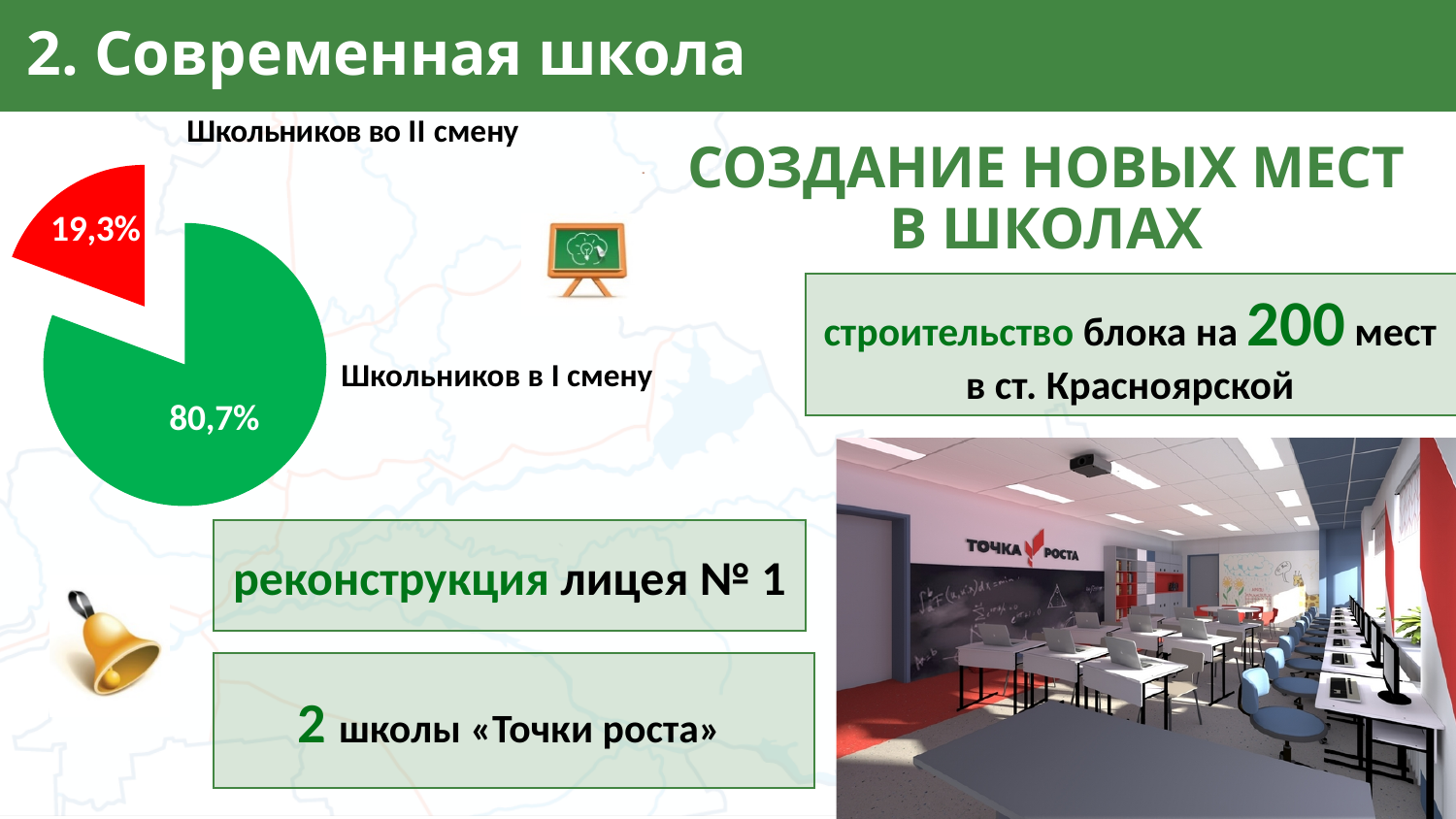
Is the share for "Школьников во II смену" in the pie chart greater or less than 50%? less What kind of chart is shown on the left of the slide? pie chart What is the difference in percentage points between the "Школьников в I смену" slice and the "Школьников во II смену" slice? 61,4 Which is larger in the pie chart: "Школьников в I смену" or "Школьников во II смену"? Школьников в I смену How many slices does the pie chart have? 2 Which slice of the pie chart is the smallest? Школьников во II смену What share of the pie chart is labelled "Школьников во II смену"? 19,3% Which slice of the pie chart is the largest? Школьников в I смену What colour is the "Школьников во II смену" slice of the pie chart? red What share of the pie chart is labelled "Школьников в I смену"? 80,7% What colour is the "Школьников в I смену" slice of the pie chart? green